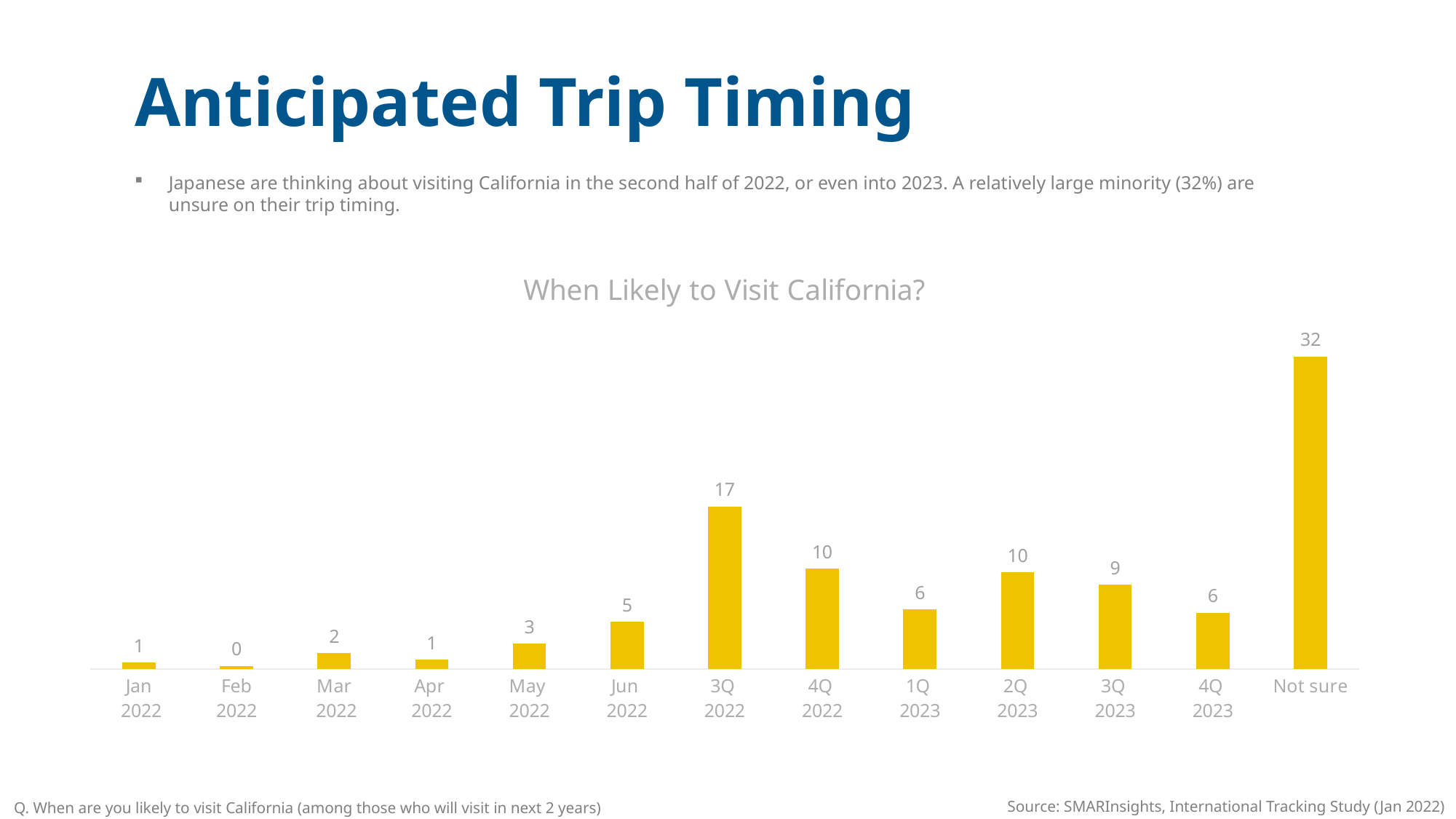
What is the value for Not sure? 32 What is the value for 3Q 2023? 9 What is the title of the chart? When Likely to Visit California? What kind of chart is shown? Bar chart What is the value for Jun 2022? 5 Which is larger, the value for 2Q 2023 or the value for 4Q 2023? 2Q 2023 What is the difference between the values for 3Q 2022 and 4Q 2022? 7 Which category has the highest value? Not sure Do the values rise or fall from Jan 2022 to Jun 2022? Rise What is the value for 3Q 2022? 17 Which category has the lowest value? Feb 2022 How many categories are shown on the x axis? 13